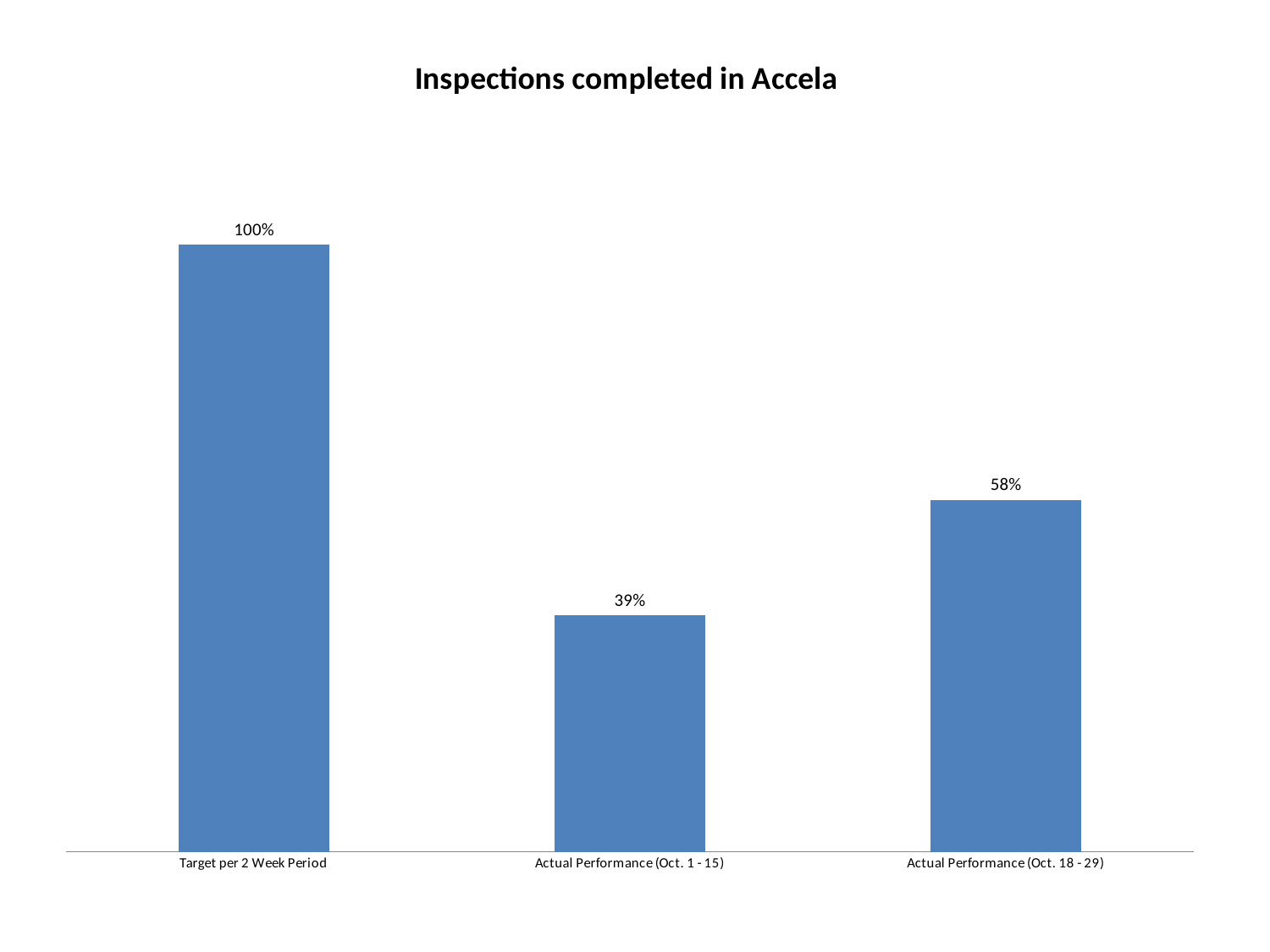
What is the value for Actual Performance (Oct. 1 - 15)? 39% Which is larger, Actual Performance (Oct. 1 - 15) or Actual Performance (Oct. 18 - 29)? Actual Performance (Oct. 18 - 29) Does the value rise or fall from Actual Performance (Oct. 1 - 15) to Actual Performance (Oct. 18 - 29)? Rise What is the title of the chart? Inspections completed in Accela What is the difference between Actual Performance (Oct. 18 - 29) and Actual Performance (Oct. 1 - 15)? 19% What kind of chart is shown on the slide? Bar chart What is the difference between the Target per 2 Week Period and Actual Performance (Oct. 18 - 29)? 42% Which category has the highest value? Target per 2 Week Period What is the value for Actual Performance (Oct. 18 - 29)? 58% How many categories are shown in the chart? 3 Which category has the lowest value? Actual Performance (Oct. 1 - 15) What is the value for Target per 2 Week Period? 100%